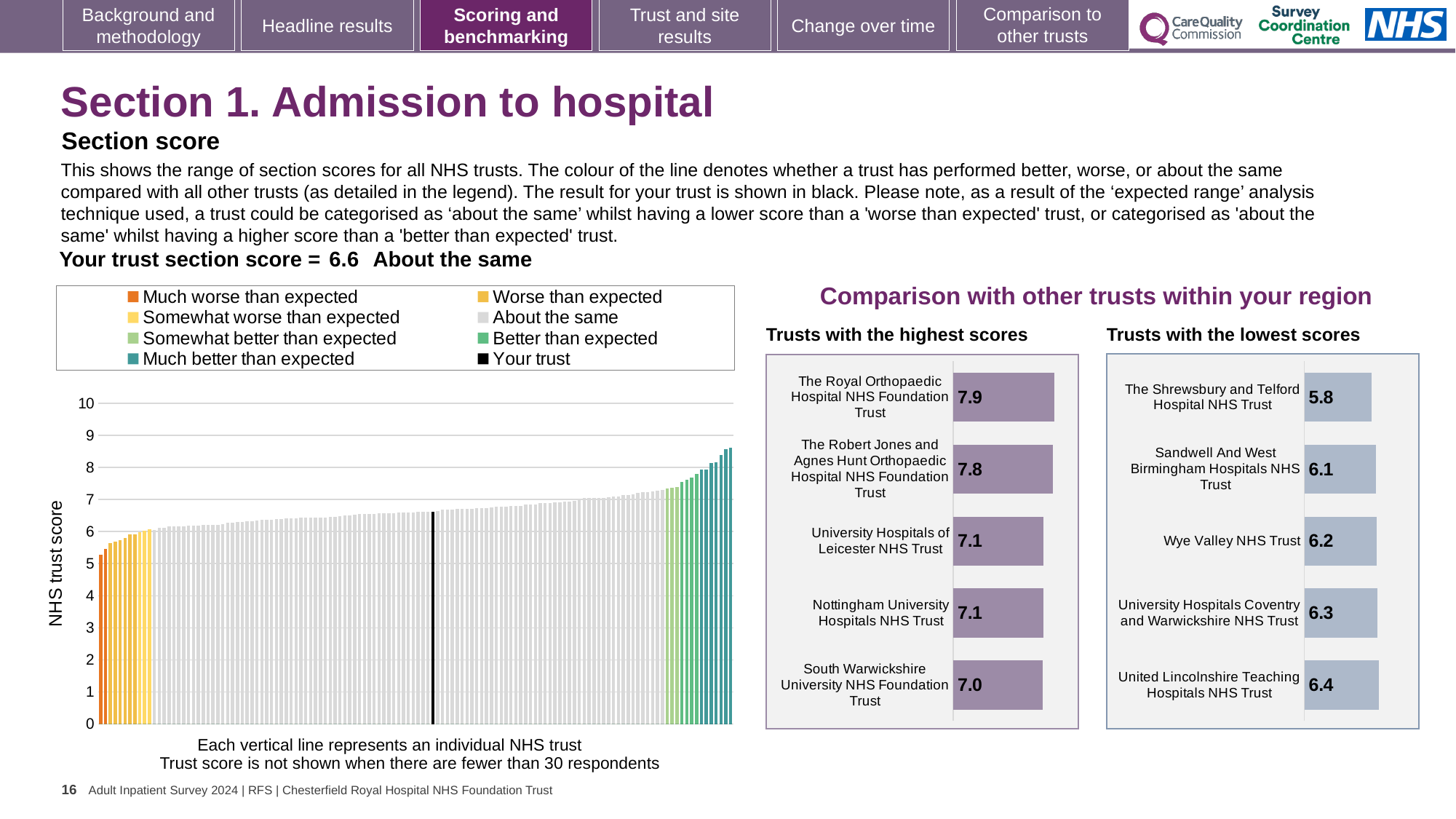
In the 'Trusts with the highest scores' chart, what is the difference between the scores of The Royal Orthopaedic Hospital NHS Foundation Trust and South Warwickshire University NHS Foundation Trust? 0.9 In the large chart of NHS trust scores on the left, what is the section score for your trust (the black line)? 6.6 In the 'Trusts with the lowest scores' chart, what is the difference between the scores of United Lincolnshire Teaching Hospitals NHS Trust and The Shrewsbury and Telford Hospital NHS Trust? 0.6 In the large chart of NHS trust scores on the left, do the values rise or fall from left to right? rise In the 'Trusts with the lowest scores' chart, what is the score for Wye Valley NHS Trust? 6.2 How many trusts are listed in the 'Trusts with the highest scores' chart? 5 In the 'Trusts with the lowest scores' chart, which trust has the highest score shown? United Lincolnshire Teaching Hospitals NHS Trust In the 'Trusts with the lowest scores' chart, which trust has the lowest score? The Shrewsbury and Telford Hospital NHS Trust How many entries does the legend of the large chart on the left list? 8 In the 'Trusts with the lowest scores' chart, which has the higher score: Sandwell And West Birmingham Hospitals NHS Trust or University Hospitals Coventry and Warwickshire NHS Trust? University Hospitals Coventry and Warwickshire NHS Trust In the 'Trusts with the highest scores' chart, which trust has the lowest score shown? South Warwickshire University NHS Foundation Trust In the 'Trusts with the highest scores' chart, what is the score for The Royal Orthopaedic Hospital NHS Foundation Trust? 7.9